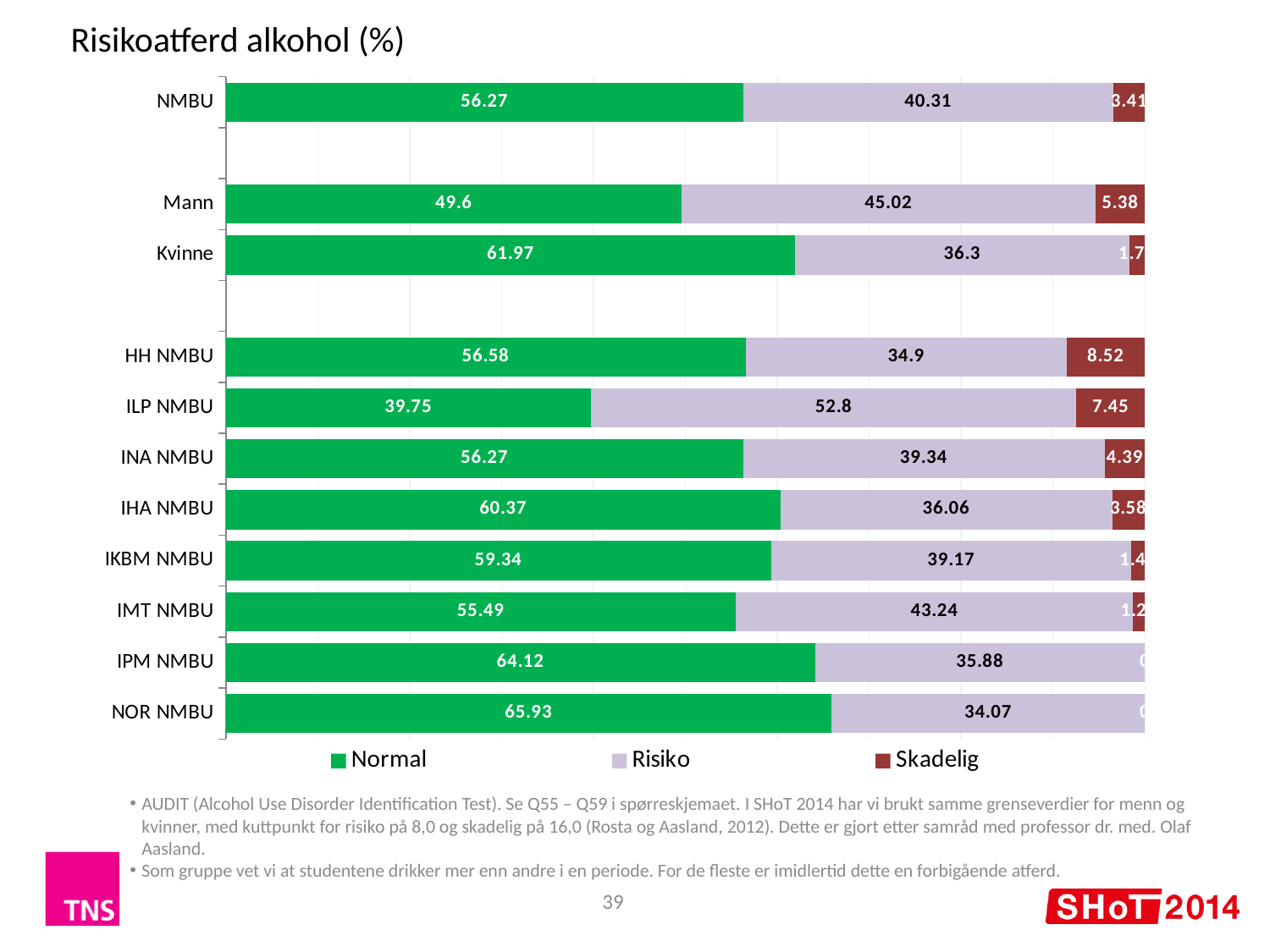
What is the difference between the Normal values for Kvinne and Mann? 12.37 Which has the larger Risiko value, ILP NMBU or HH NMBU? ILP NMBU What is the total of the stacked bar for IPM NMBU? 100 How many series does the legend list? 3 Which category has the highest Normal value? NOR NMBU How many categories are plotted on the chart? 11 What is the Normal value for Mann? 49.6 Which category has the lowest Normal value? ILP NMBU What is the Risiko value for ILP NMBU? 52.8 What is the Skadelig value for HH NMBU? 8.52 Which category has the highest Skadelig value? HH NMBU What kind of chart is shown on the slide? Stacked bar chart